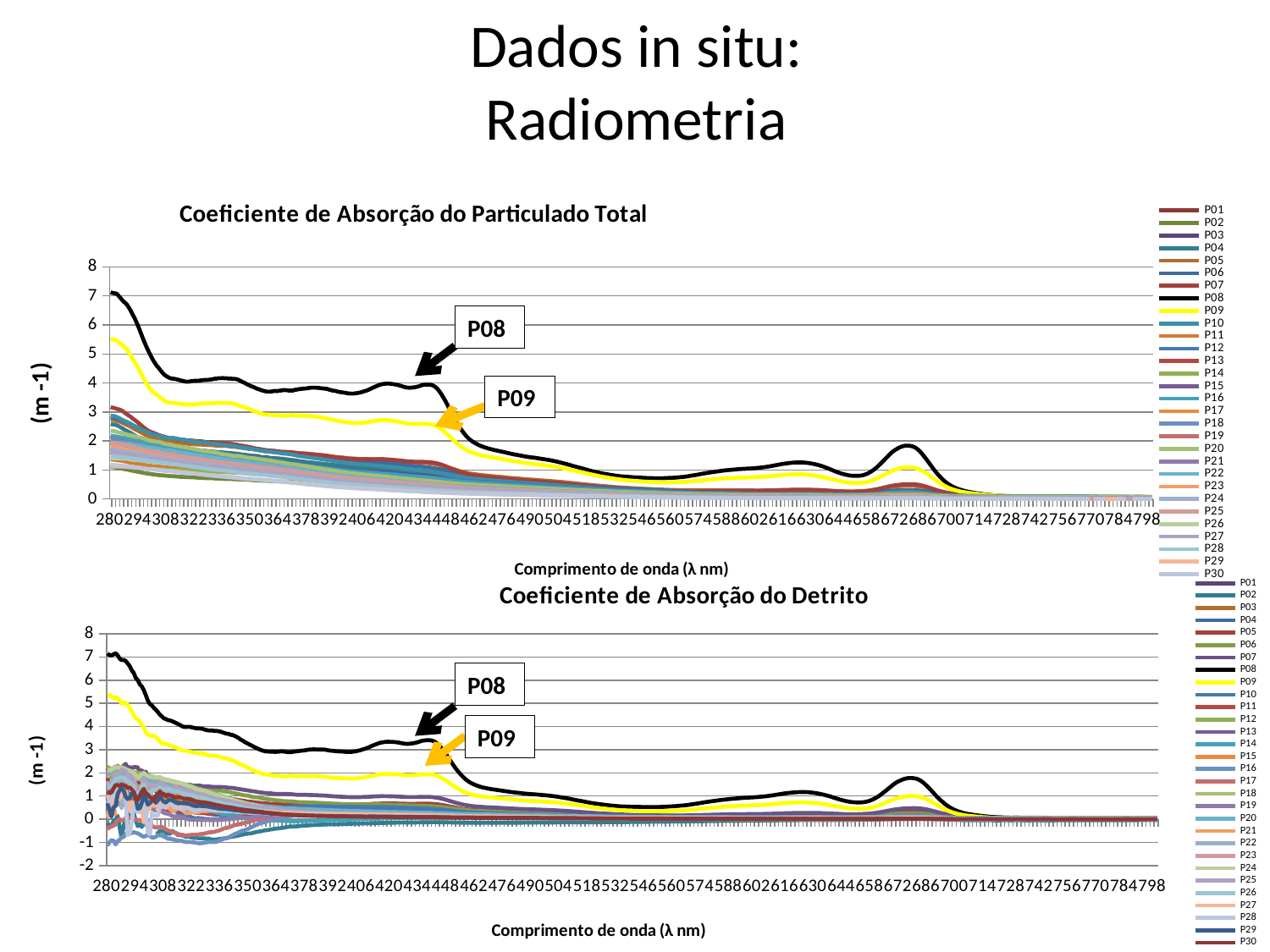
In the 'Coeficiente de Absorção do Detrito' chart, is the value of P08 at 280 nm greater or less than 6? greater What is the x-axis label of the 'Coeficiente de Absorção do Detrito' chart? Comprimento de onda (λ nm) What is the lowest value shown on the y axis of the 'Coeficiente de Absorção do Detrito' chart? -2 In the 'Coeficiente de Absorção do Particulado Total' chart, which is larger at 280 nm, P08 or P09? P08 How many series does the legend of the 'Coeficiente de Absorção do Detrito' chart list? 30 How many series does the legend of the 'Coeficiente de Absorção do Particulado Total' chart list? 30 In the 'Coeficiente de Absorção do Particulado Total' chart, is the value of P08 at 280 nm greater or less than 6? greater What type of chart is the 'Coeficiente de Absorção do Particulado Total' chart? line chart In the 'Coeficiente de Absorção do Particulado Total' chart, which series has the highest value at 280 nm? P08 In the 'Coeficiente de Absorção do Particulado Total' chart, is the value of P09 at 280 nm greater or less than 4? greater In the 'Coeficiente de Absorção do Particulado Total' chart, does the P08 series overall rise or fall as wavelength increases from 280 to 798 nm? fall In the 'Coeficiente de Absorção do Detrito' chart, which series has the highest value at 280 nm? P08